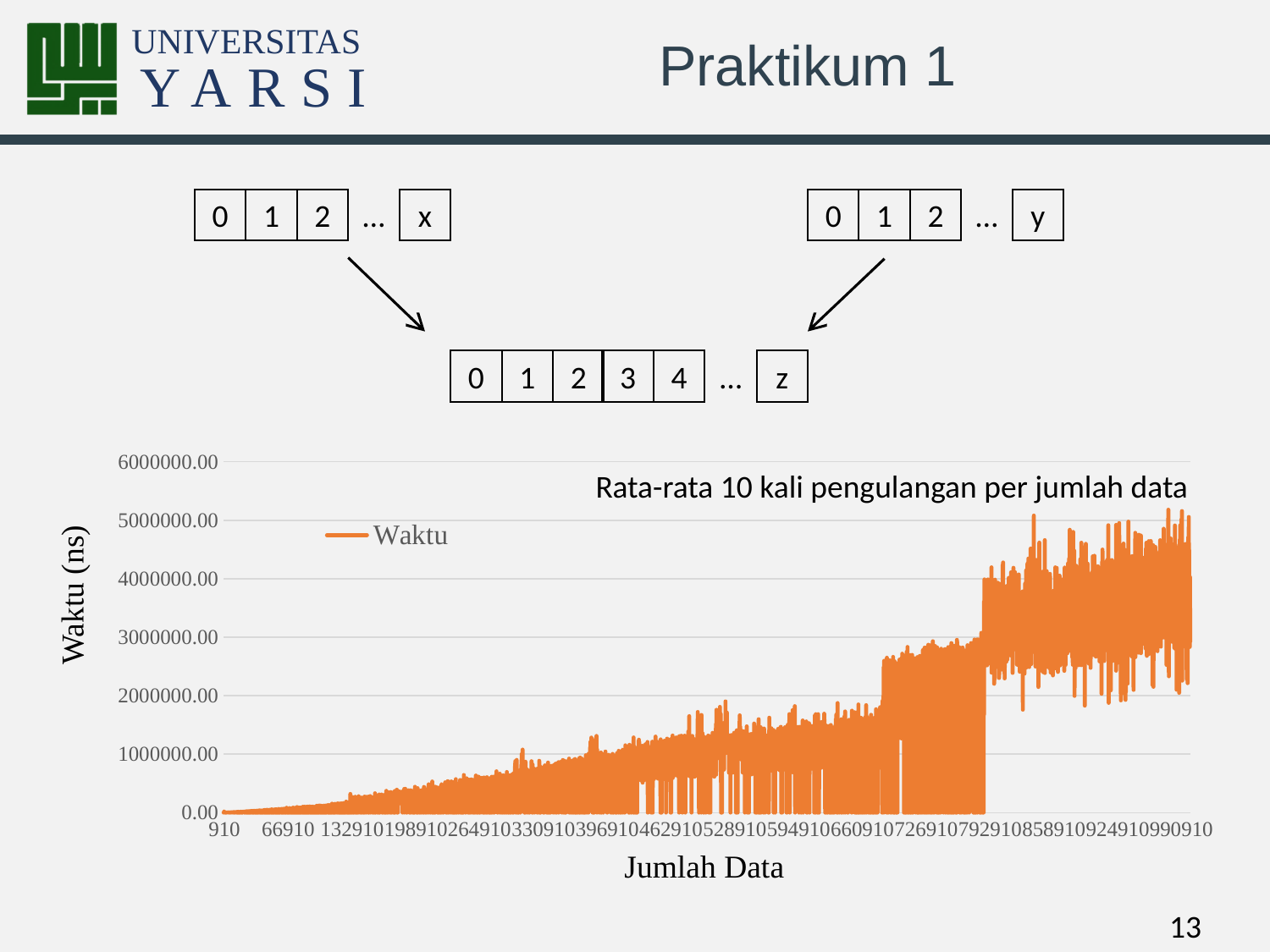
Is the Waktu value at Jumlah Data 910 greater or less than 1000000.00? less What is the name of the series shown in the chart legend? Waktu What is the title of the vertical axis of the chart? Waktu (ns) Overall, do the Waktu values rise or fall as Jumlah Data increases along the x axis? rise Is the Waktu value at Jumlah Data 330910 greater or less than 3000000.00? less What kind of chart is shown on the slide? line chart How many series does the chart legend list? 1 Is the Waktu value at Jumlah Data 66910 greater or less than 1000000.00? less Which is larger, the Waktu value at Jumlah Data 66910 or at Jumlah Data 858910? 858910